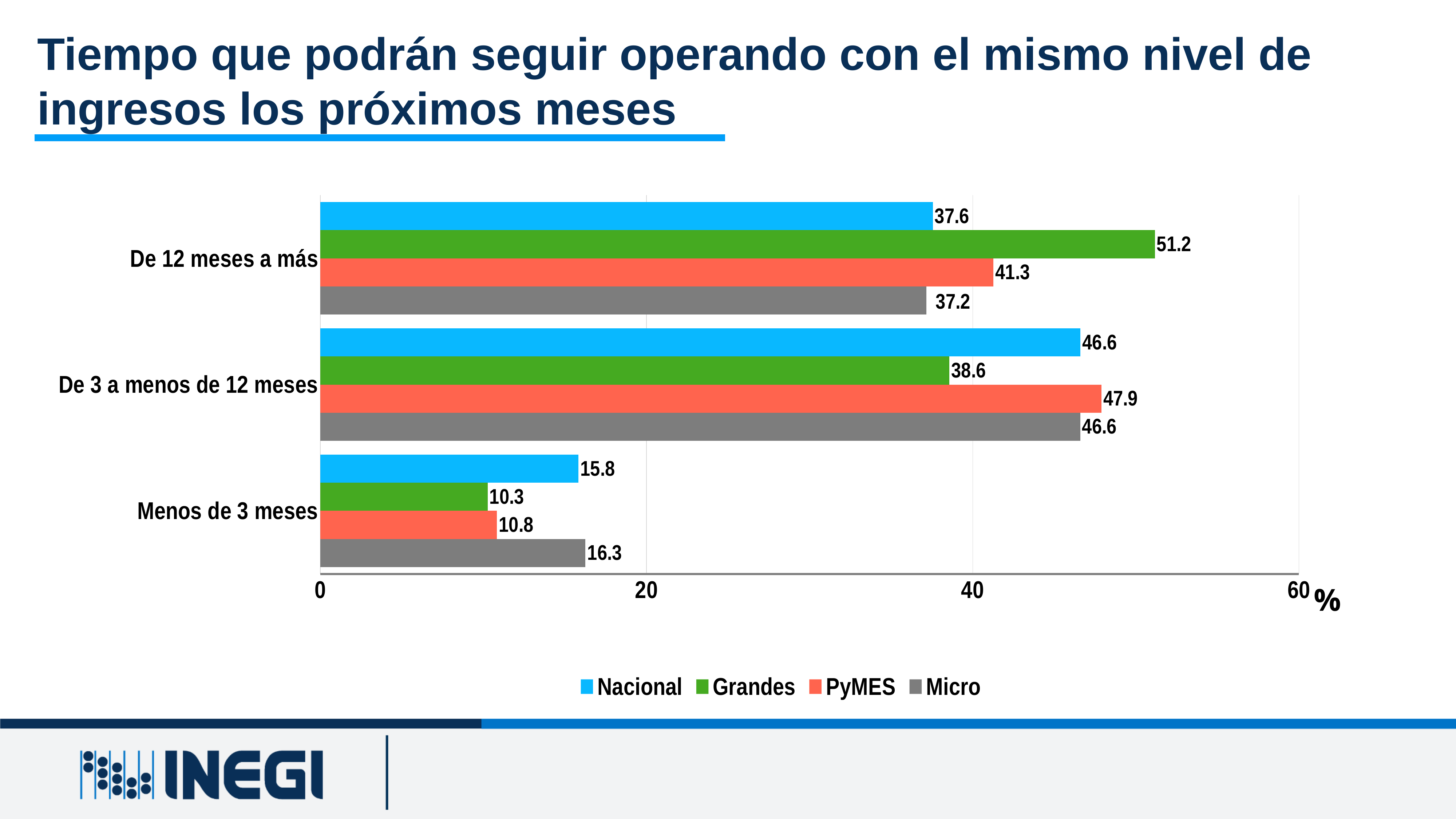
In the 'De 3 a menos de 12 meses' category, which is larger: the Nacional value or the Grandes value? Nacional What is the value for Nacional in the 'Menos de 3 meses' category? 15.8 How many categories are shown on the chart? 3 How many series does the legend list? 4 Is the value for PyMES in the 'De 12 meses a más' category greater or less than 40? greater What kind of chart is shown on the slide? Bar chart What is the difference between the Grandes and Nacional values in the 'De 12 meses a más' category? 13.6 What is the value for Micro in the 'Menos de 3 meses' category? 16.3 What is the value for PyMES in the 'De 3 a menos de 12 meses' category? 47.9 What is the value for Grandes in the 'De 12 meses a más' category? 51.2 Which series has the highest value in the 'De 12 meses a más' category? Grandes Which series has the lowest value in the 'Menos de 3 meses' category? Grandes